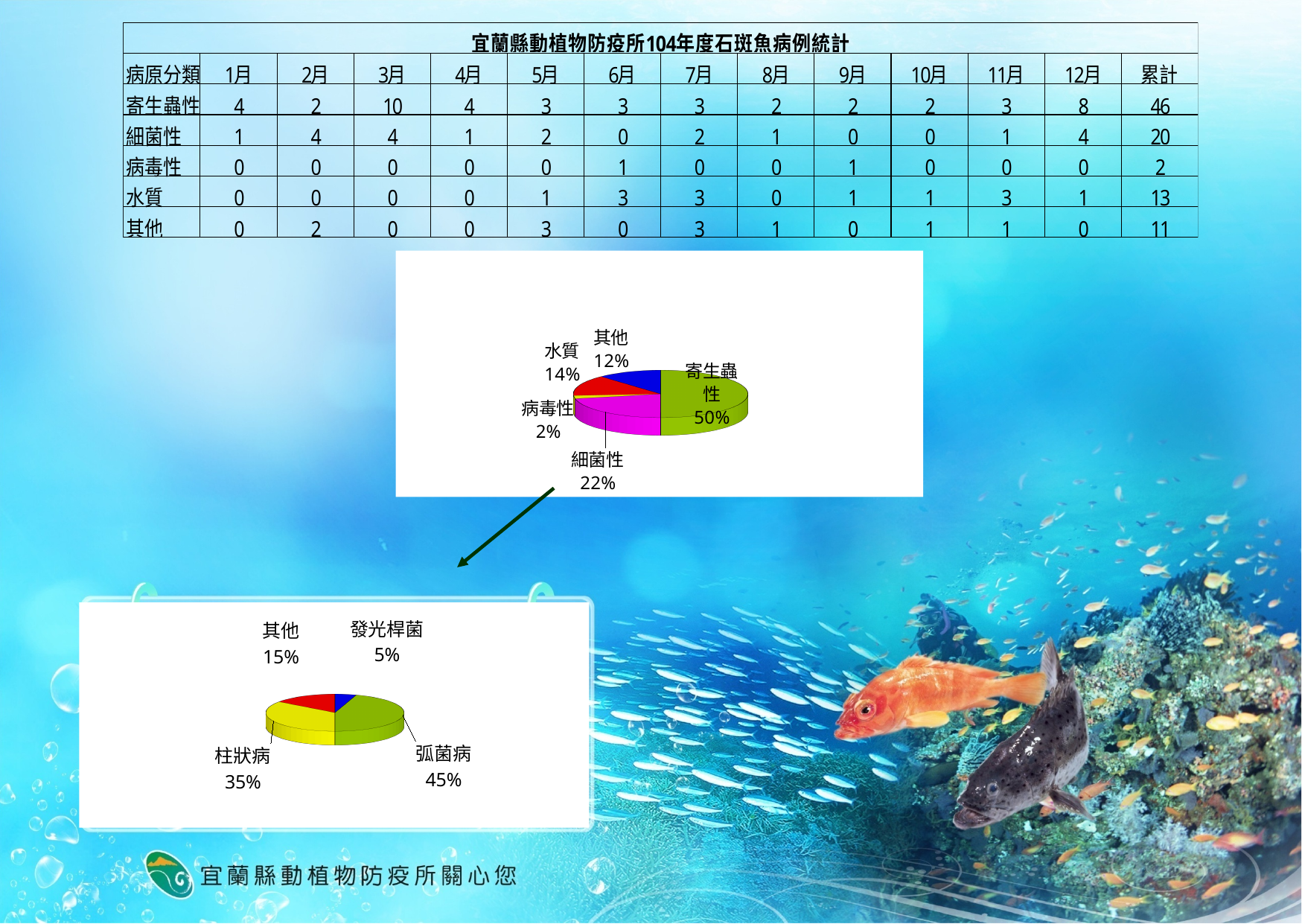
How many slices does the upper pie chart have? 5 In the upper pie chart, what share does 細菌性 have? 22% In the upper pie chart, which category has the smallest share? 病毒性 In the lower pie chart, what share does 弧菌病 have? 45% In the upper pie chart, what colour is the 細菌性 slice? magenta In the upper pie chart, what share does 寄生蟲性 have? 50% In the upper pie chart, what is the difference between the shares of 水質 and 其他? 2% In the lower pie chart, what is the difference between the shares of 弧菌病 and 柱狀病? 10% What kind of chart is the lower chart on the slide? pie chart In the lower pie chart, which category has the smallest share? 發光桿菌 In the upper pie chart, which category has the largest share? 寄生蟲性 In the lower pie chart, which is larger, 柱狀病 or 其他? 柱狀病